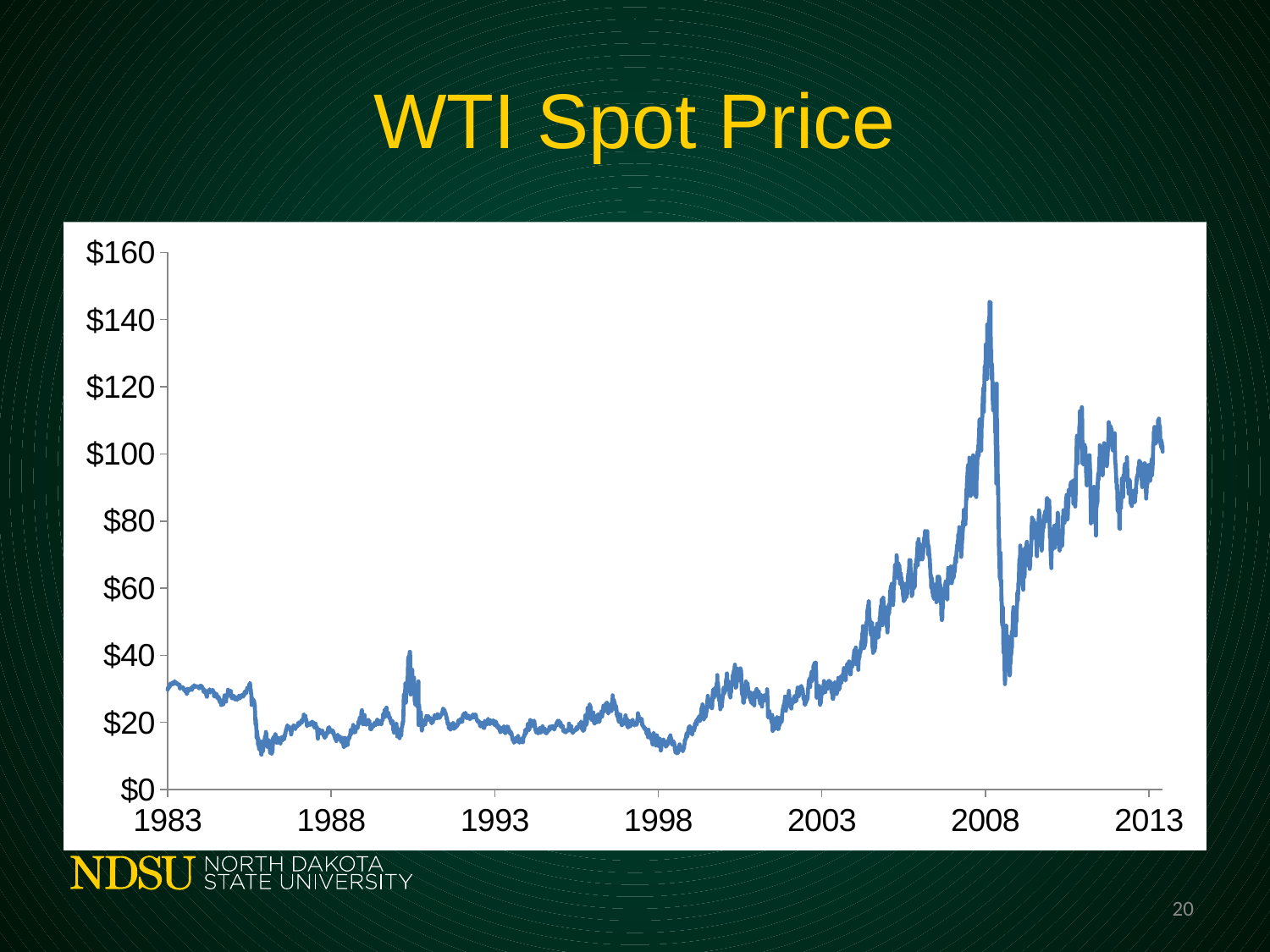
Is the WTI spot price at the 2013 end of the chart greater or less than $80? greater How many lines (series) are plotted on the chart? 1 Is the peak value of the WTI spot price greater or less than $140? greater Is the WTI spot price at the start of 1983 greater or less than $40? less What kind of chart is shown on the slide? line chart How many year labels are shown on the x axis? 7 What is the title of the chart? WTI Spot Price Overall, does the WTI spot price rise or fall from 1983 to 2013? rise Near which labelled year does the WTI spot price reach its highest peak? 2008 What is the highest value labelled on the y axis? $160 Which is higher: the WTI spot price peak near 2008 or the price at the 2013 end of the chart? the peak near 2008